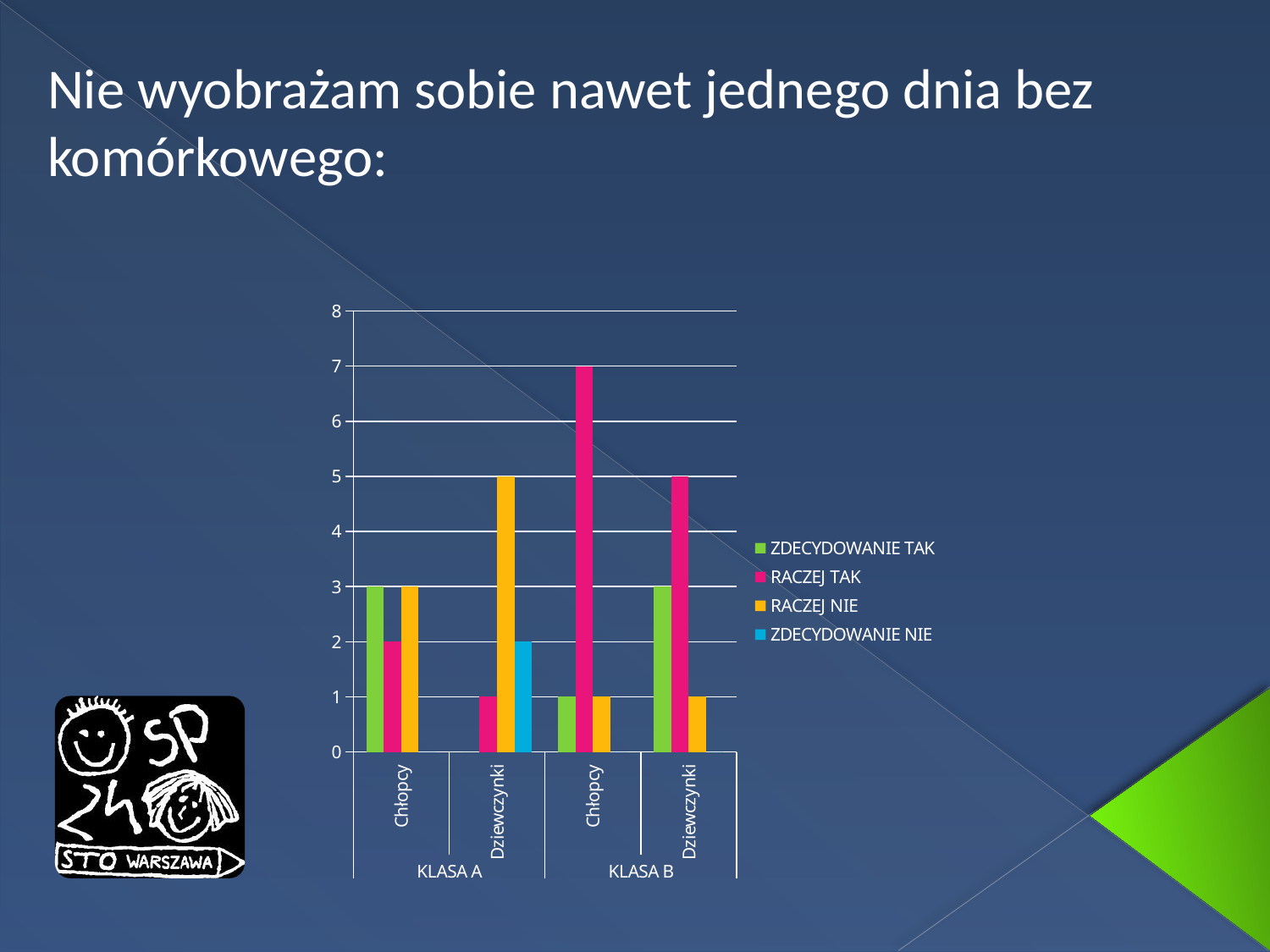
Is the RACZEJ TAK value for Chłopcy in KLASA B greater or less than 6? greater Which is larger: RACZEJ NIE for Dziewczynki in KLASA A or RACZEJ NIE for Chłopcy in KLASA A? Dziewczynki in KLASA A What is the value of ZDECYDOWANIE NIE for Dziewczynki in KLASA A? 2 What colour represents the RACZEJ NIE series? orange What kind of chart is shown on the slide? bar chart Which group has the highest RACZEJ TAK value? Chłopcy in KLASA B What is the value of RACZEJ TAK for Chłopcy in KLASA B? 7 How many series does the legend list? 4 What is the value of RACZEJ NIE for Dziewczynki in KLASA A? 5 What is the difference between the RACZEJ TAK values for Chłopcy in KLASA B and Dziewczynki in KLASA B? 2 How many groups are shown on the x axis? 4 What is the value of ZDECYDOWANIE TAK for Chłopcy in KLASA A? 3